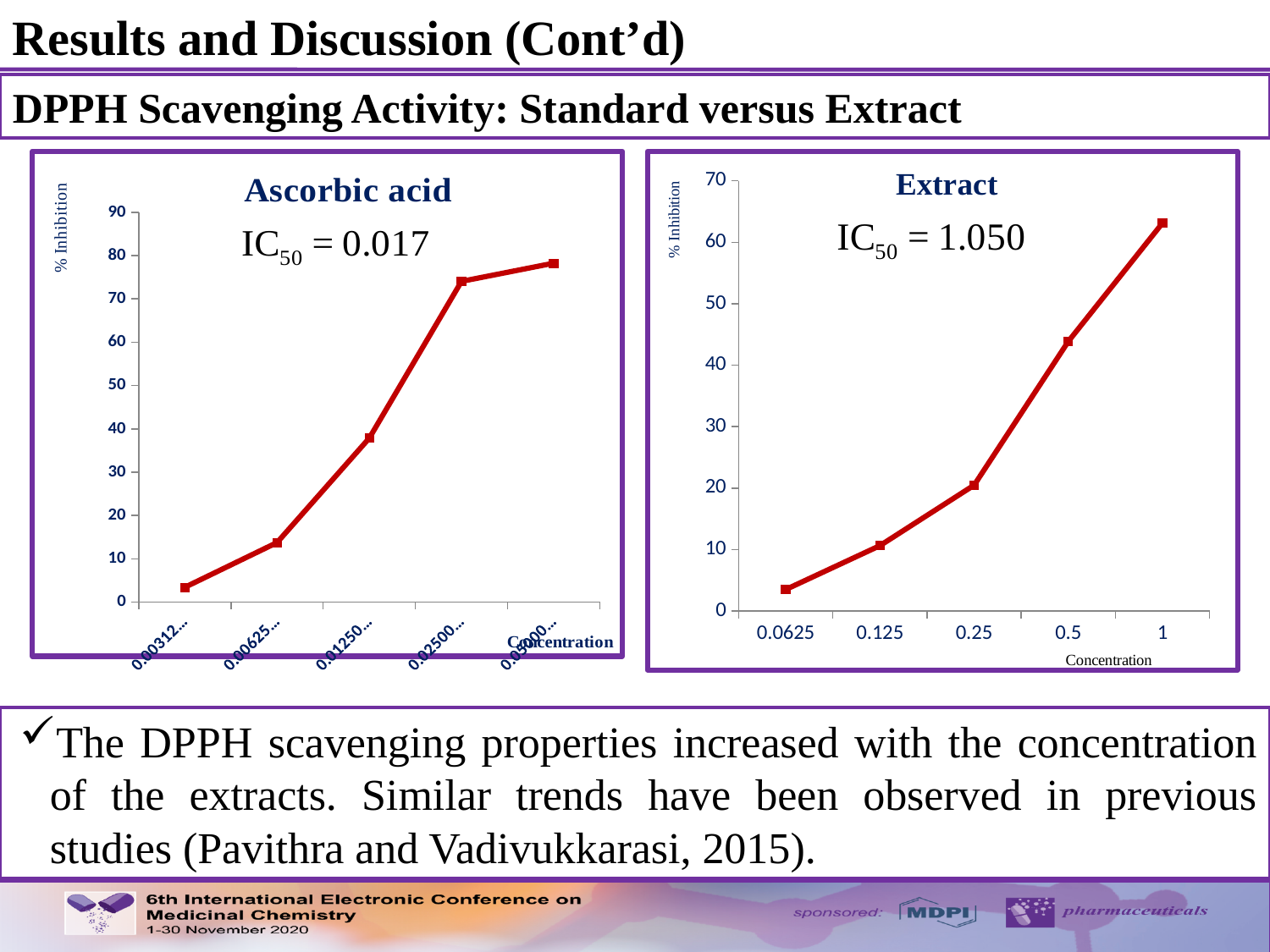
In the Ascorbic acid chart, do the % Inhibition values rise or fall along the x axis? Rise In the Extract chart, which concentration has the highest % Inhibition? 1 In the Extract chart, is the value at concentration 0.25 greater or less than 30? less In the Extract chart, do the % Inhibition values rise or fall as concentration increases along the x axis? Rise In the Extract chart, which has the larger % Inhibition: concentration 0.5 or concentration 0.125? 0.5 In the Extract chart, how many data points are plotted? 5 In the Extract chart, which concentration has the lowest % Inhibition? 0.0625 In the Ascorbic acid chart, how many data points are plotted? 5 In the Extract chart, is the value at concentration 1 greater or less than 60? greater In the Extract chart, is the value at concentration 0.0625 greater or less than 10? less What IC50 value is shown on the Extract chart? IC50 = 1.050 What type of chart is the Ascorbic acid chart? Line chart